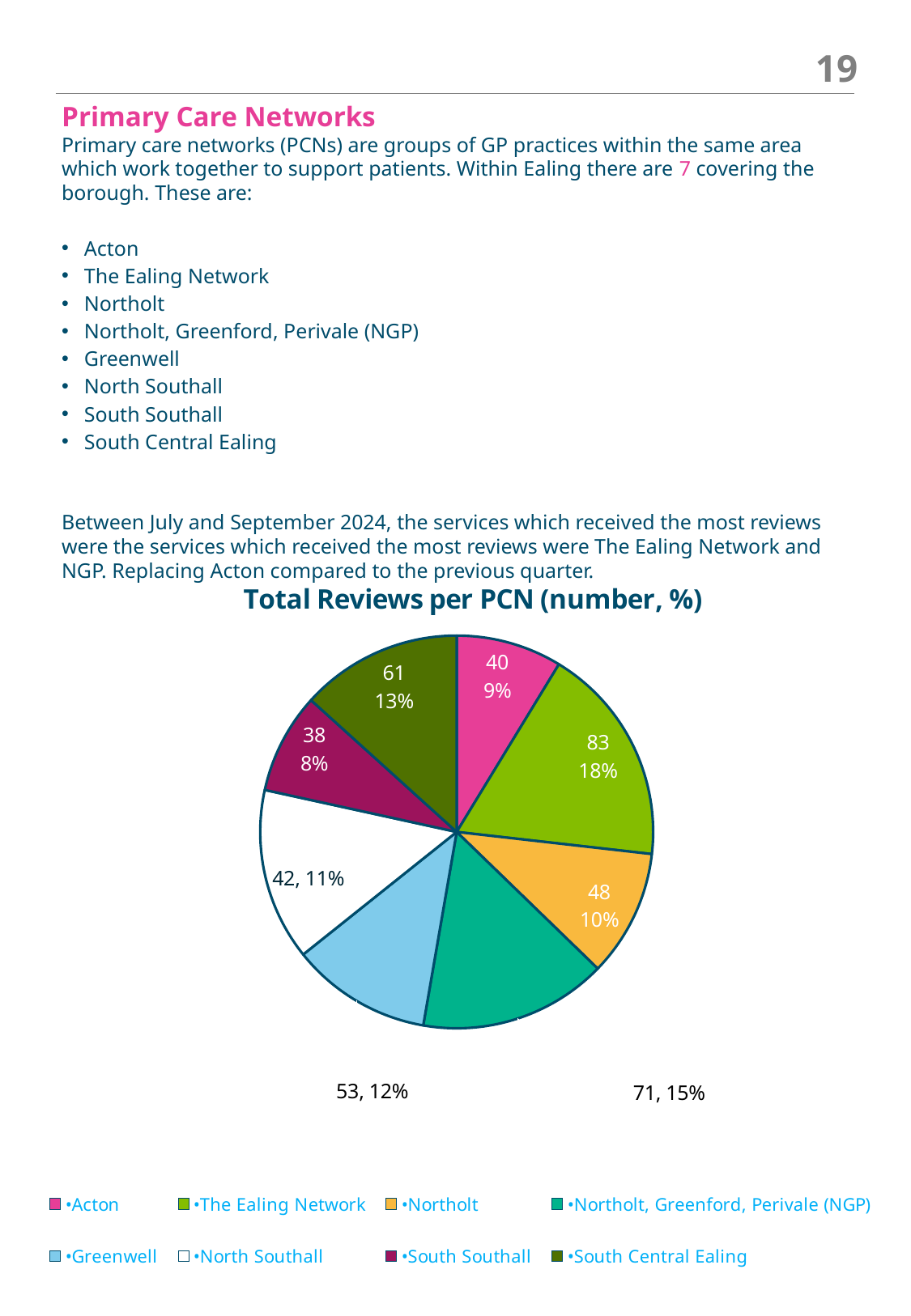
Which PCN received the fewest reviews? South Southall What percentage share of reviews does Acton have? 9% Which received more reviews, South Central Ealing or Greenwell? South Central Ealing What is the title of the chart? Total Reviews per PCN (number, %) How many reviews did The Ealing Network receive according to the chart? 83 What is the difference in the number of reviews between The Ealing Network and South Southall? 45 Which PCN received the most reviews? The Ealing Network How many slices does the pie chart have? 8 How many PCNs are listed in the chart legend? 8 What percentage share of reviews does Northolt, Greenford, Perivale (NGP) have? 15% What kind of chart is shown on the slide? Pie chart How many reviews did Northolt receive? 48